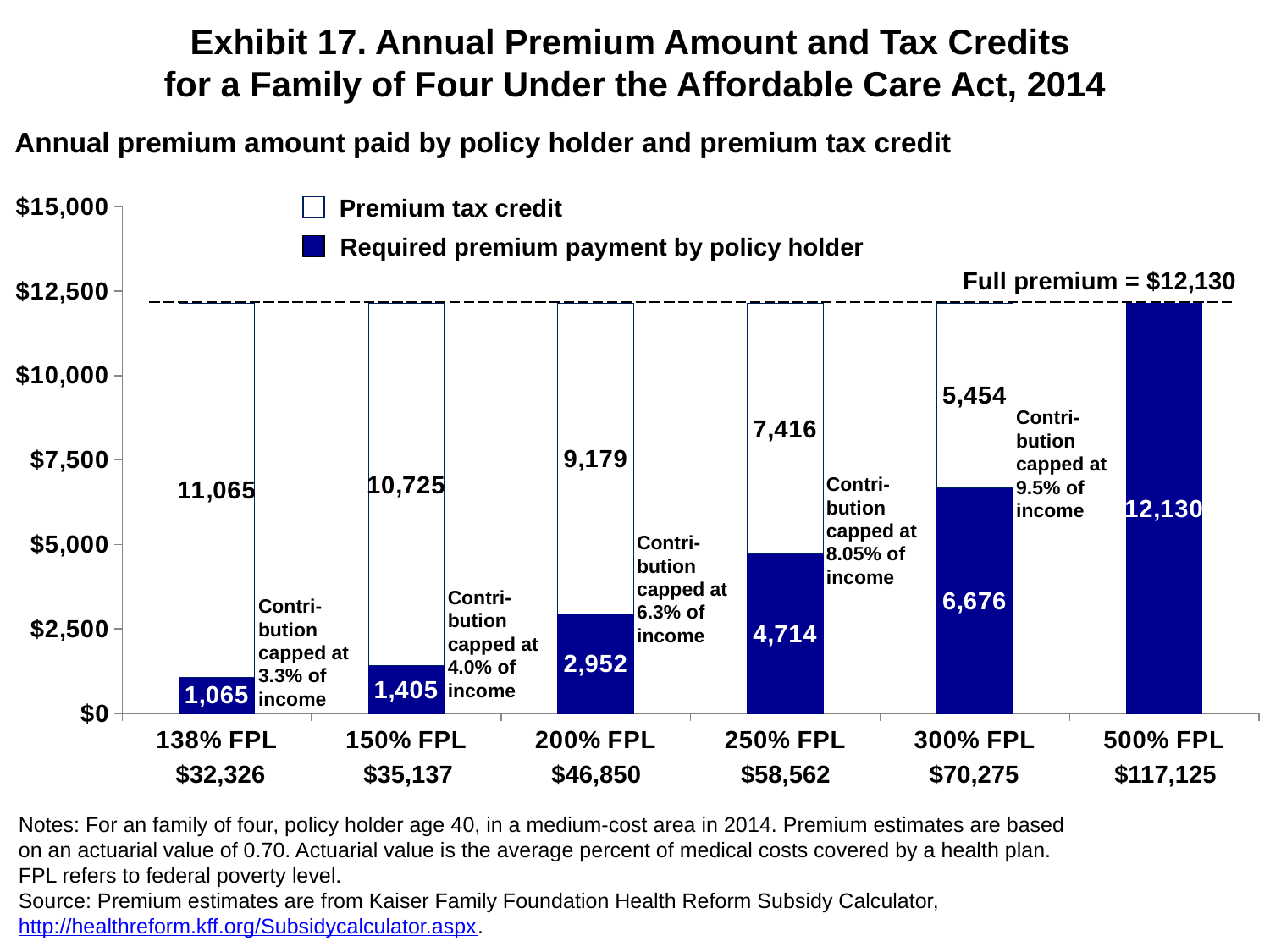
How many FPL categories are shown on the x axis? 6 Which FPL category has the highest required premium payment by the policy holder? 500% FPL What is the required premium payment by the policy holder at 300% FPL? 6,676 What is the required premium payment by the policy holder at 200% FPL? 2,952 Which FPL category has the lowest required premium payment by the policy holder? 138% FPL How many series does the legend list? 2 What kind of chart is shown on the slide? Stacked bar chart Which is larger at 300% FPL: the premium tax credit or the required premium payment by the policy holder? Required premium payment by policy holder What is the premium tax credit at 250% FPL? 7,416 Does the required premium payment by the policy holder rise or fall as the FPL percentage increases along the x axis? Rise What is the difference between the premium tax credit at 138% FPL and at 150% FPL? 340 What is the total of the stacked bar at 150% FPL (premium tax credit plus required premium payment)? 12,130